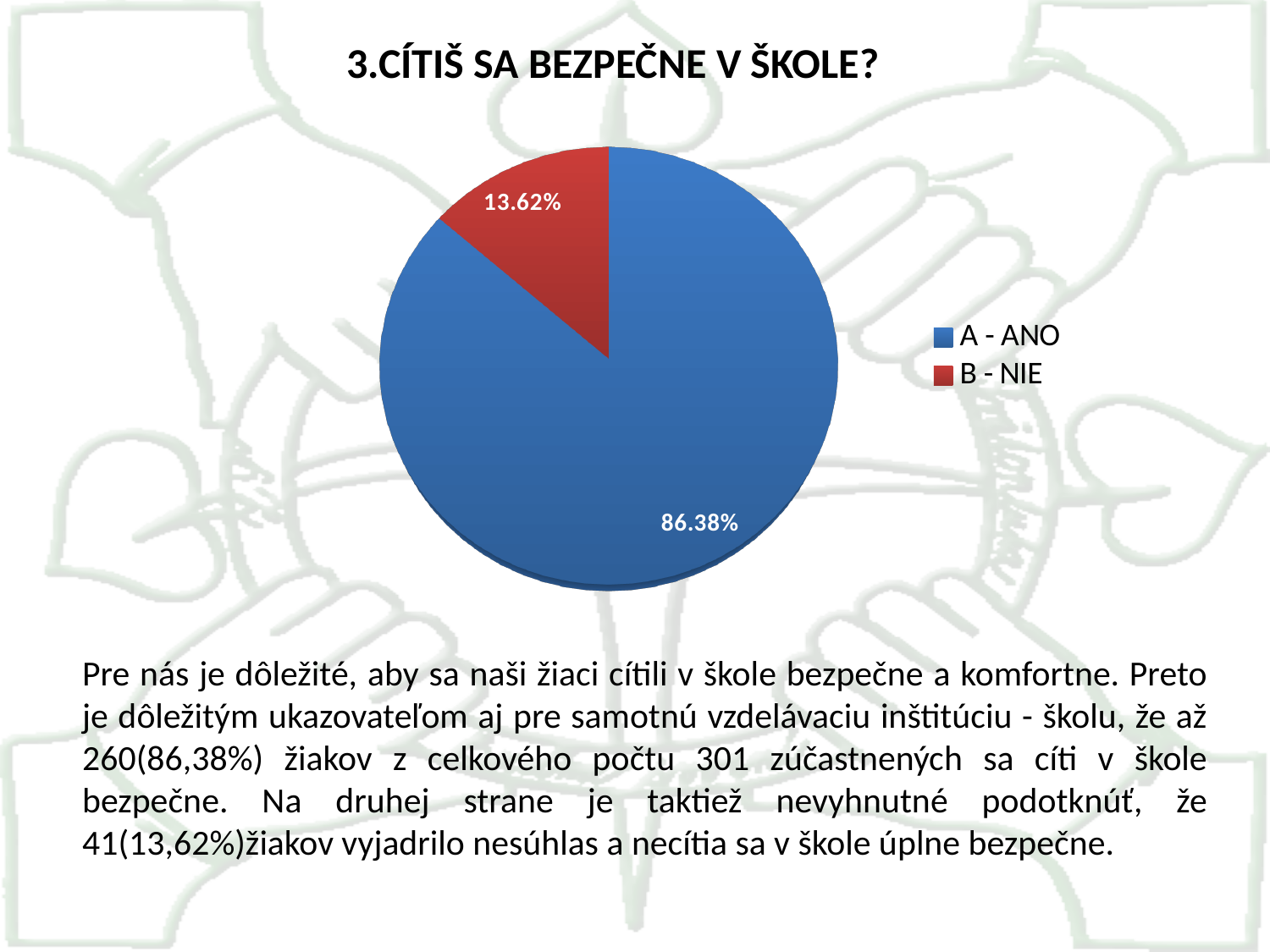
How many entries does the legend list? 2 Which slice of the pie is the largest? A - ANO What share of the pie does the slice 'B - NIE' represent? 13.62% How many slices does the pie chart have? 2 Which slice of the pie is the smallest? B - NIE What share of the pie does the slice 'A - ANO' represent? 86.38% What colour is the slice for 'B - NIE'? red What is the difference in percentage points between the 'A - ANO' slice and the 'B - NIE' slice? 72.76 Which is larger, the slice for 'A - ANO' or the slice for 'B - NIE'? A - ANO What is the title of the chart? 3.CÍTIŠ SA BEZPEČNE V ŠKOLE? What kind of chart is shown on the slide? pie chart